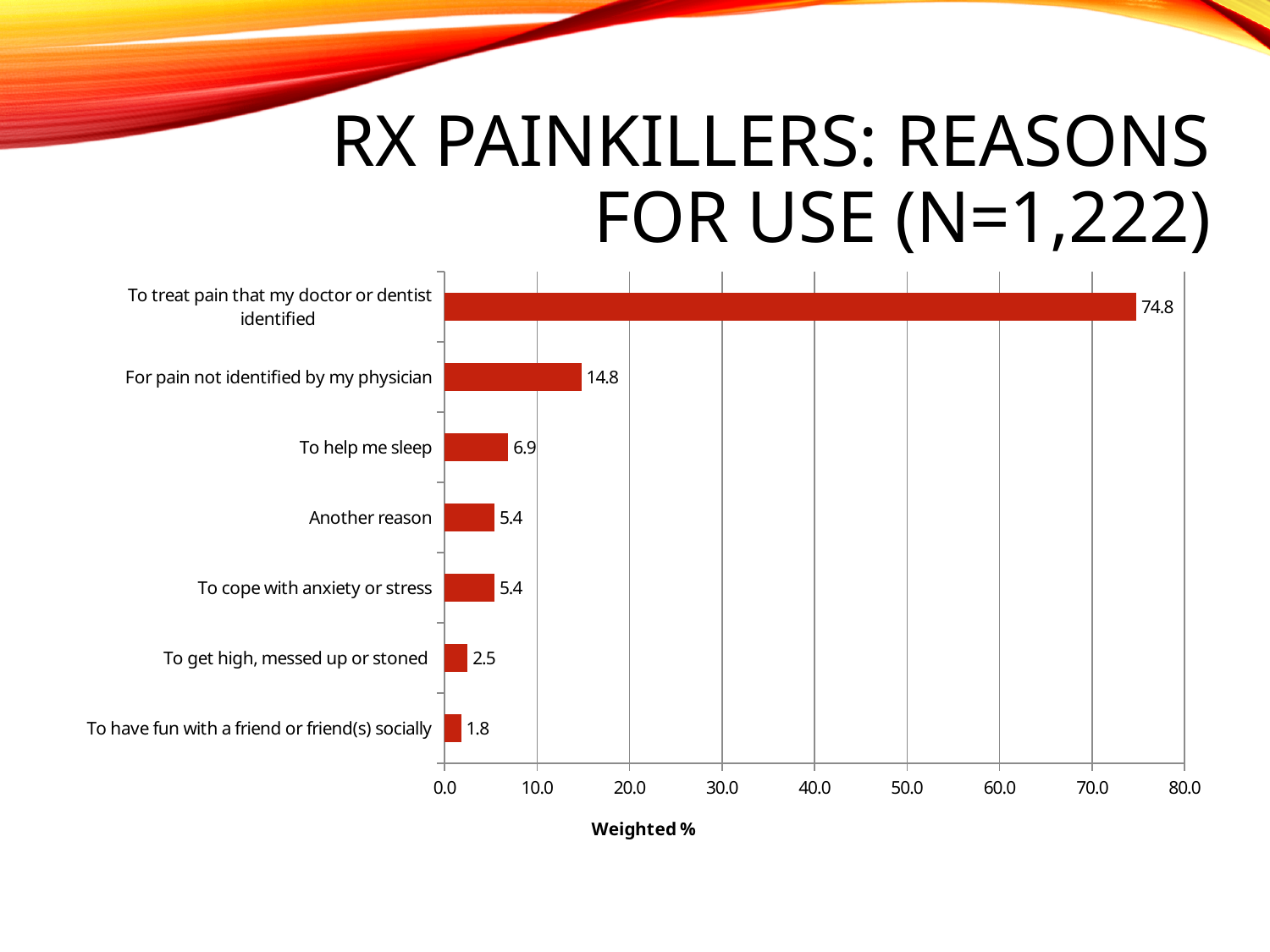
Which reason has the lowest weighted %? To have fun with a friend or friend(s) socially What kind of chart is shown on the slide? Bar chart What is the weighted % for "For pain not identified by my physician"? 14.8 How many reasons for use are shown in the chart? 7 What is the difference in weighted % between "To treat pain that my doctor or dentist identified" and "For pain not identified by my physician"? 60.0 Which has a higher weighted %: "To help me sleep" or "To get high, messed up or stoned"? To help me sleep What is the label of the horizontal axis? Weighted % What is the weighted % for "To treat pain that my doctor or dentist identified"? 74.8 Is the value for "For pain not identified by my physician" greater or less than 10.0? greater What is the weighted % for "To get high, messed up or stoned"? 2.5 What is the weighted % for "To help me sleep"? 6.9 Which reason has the highest weighted %? To treat pain that my doctor or dentist identified